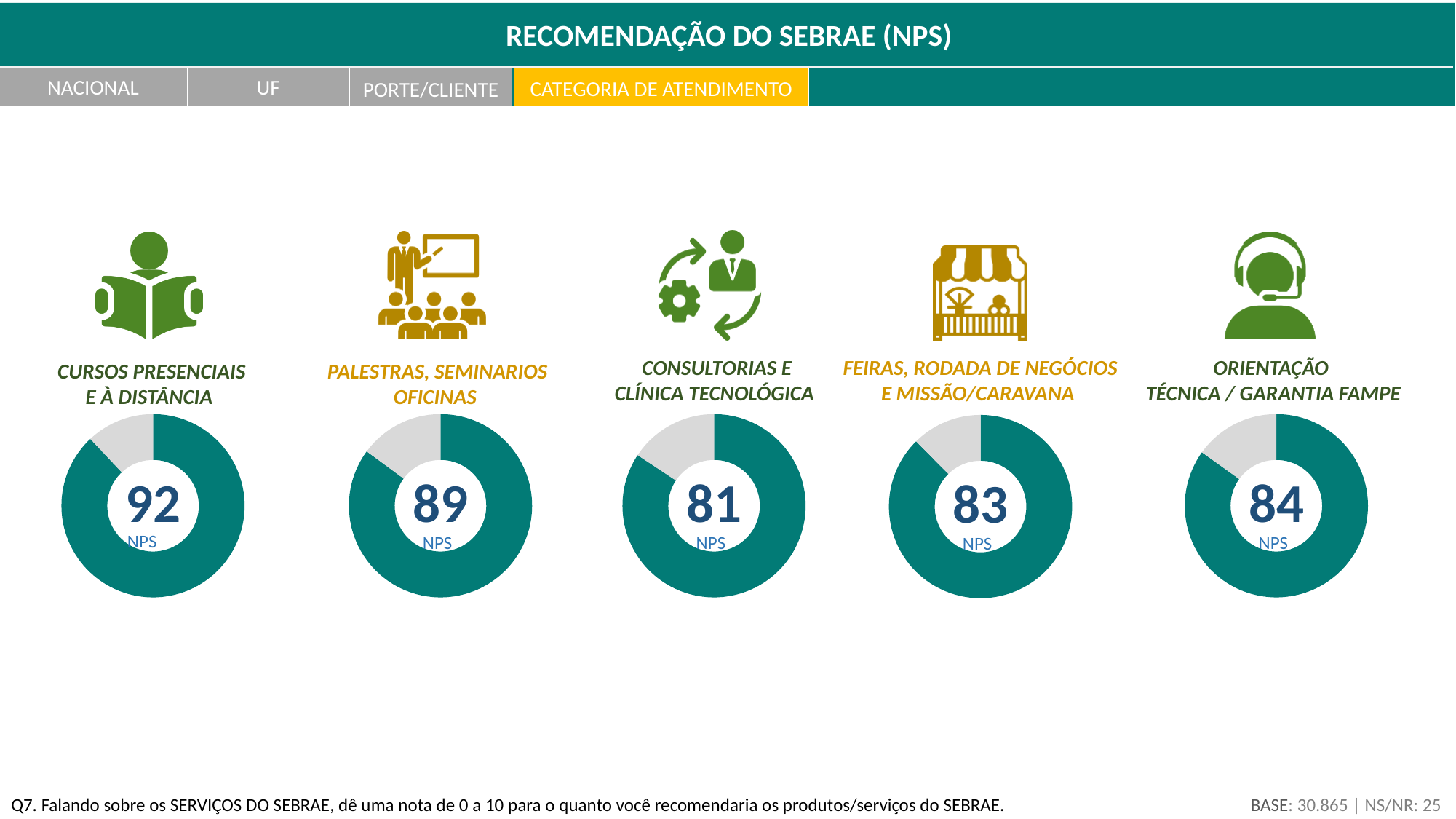
How many donut charts are shown on the slide? 5 What is the difference between the NPS for Cursos Presenciais e à Distância and the NPS for Consultorias e Clínica Tecnológica? 11 What is the NPS value shown in the donut chart for Palestras, Seminarios, Oficinas? 89 Which has a higher NPS: Feiras, Rodada de Negócios e Missão/Caravana or Orientação Técnica / Garantia Fampe? Orientação Técnica / Garantia Fampe What is the NPS value shown in the donut chart for Orientação Técnica / Garantia Fampe? 84 Across the five donut charts on the slide, which category has the lowest NPS? Consultorias e Clínica Tecnológica What is the NPS value shown in the donut chart for Cursos Presenciais e à Distância? 92 What is the NPS value shown in the donut chart for Consultorias e Clínica Tecnológica? 81 What is the NPS value shown in the donut chart for Feiras, Rodada de Negócios e Missão/Caravana? 83 What kind of chart is used to display each NPS value on the slide? Donut chart Across the five donut charts on the slide, which category has the highest NPS? Cursos Presenciais e à Distância What is the title of the slide containing the NPS donut charts? RECOMENDAÇÃO DO SEBRAE (NPS)